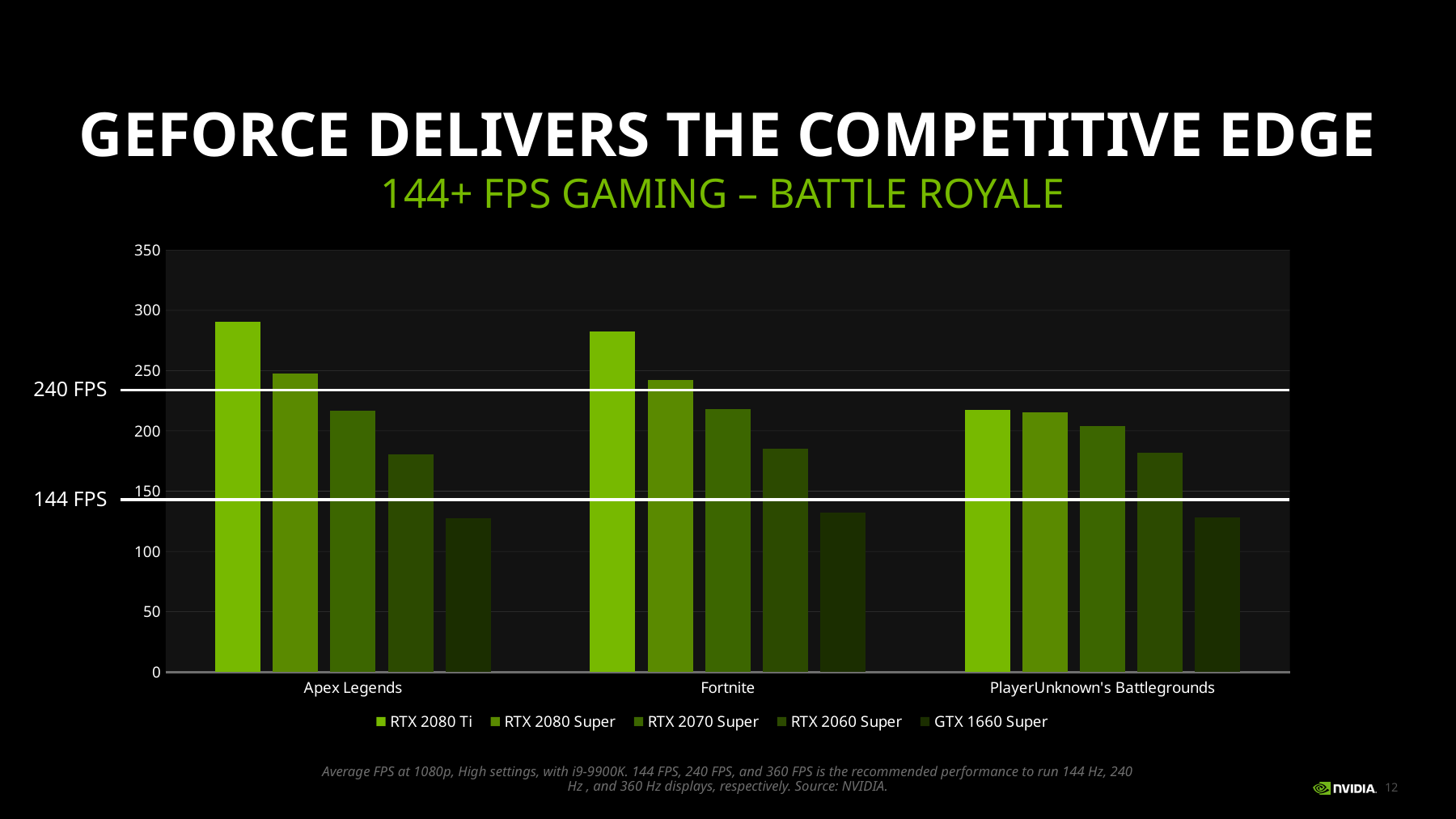
What kind of chart is shown on the slide? bar chart Is the value for RTX 2060 Super in Fortnite greater or less than 150? greater What are the two labelled horizontal reference lines on the chart? 240 FPS and 144 FPS How many games (categories) are shown on the x axis of the chart? 3 What is the subtitle shown in green above the chart? 144+ FPS GAMING – BATTLE ROYALE Is the value for RTX 2080 Ti in PlayerUnknown's Battlegrounds greater or less than 250? less In Fortnite, which is larger: the value for RTX 2080 Ti or the value for RTX 2070 Super? RTX 2080 Ti Is the value for GTX 1660 Super in Apex Legends greater or less than 150? less How many series does the chart's legend list? 5 Which GPU has the lowest bar for Fortnite? GTX 1660 Super Which GPU has the highest bar for Apex Legends? RTX 2080 Ti